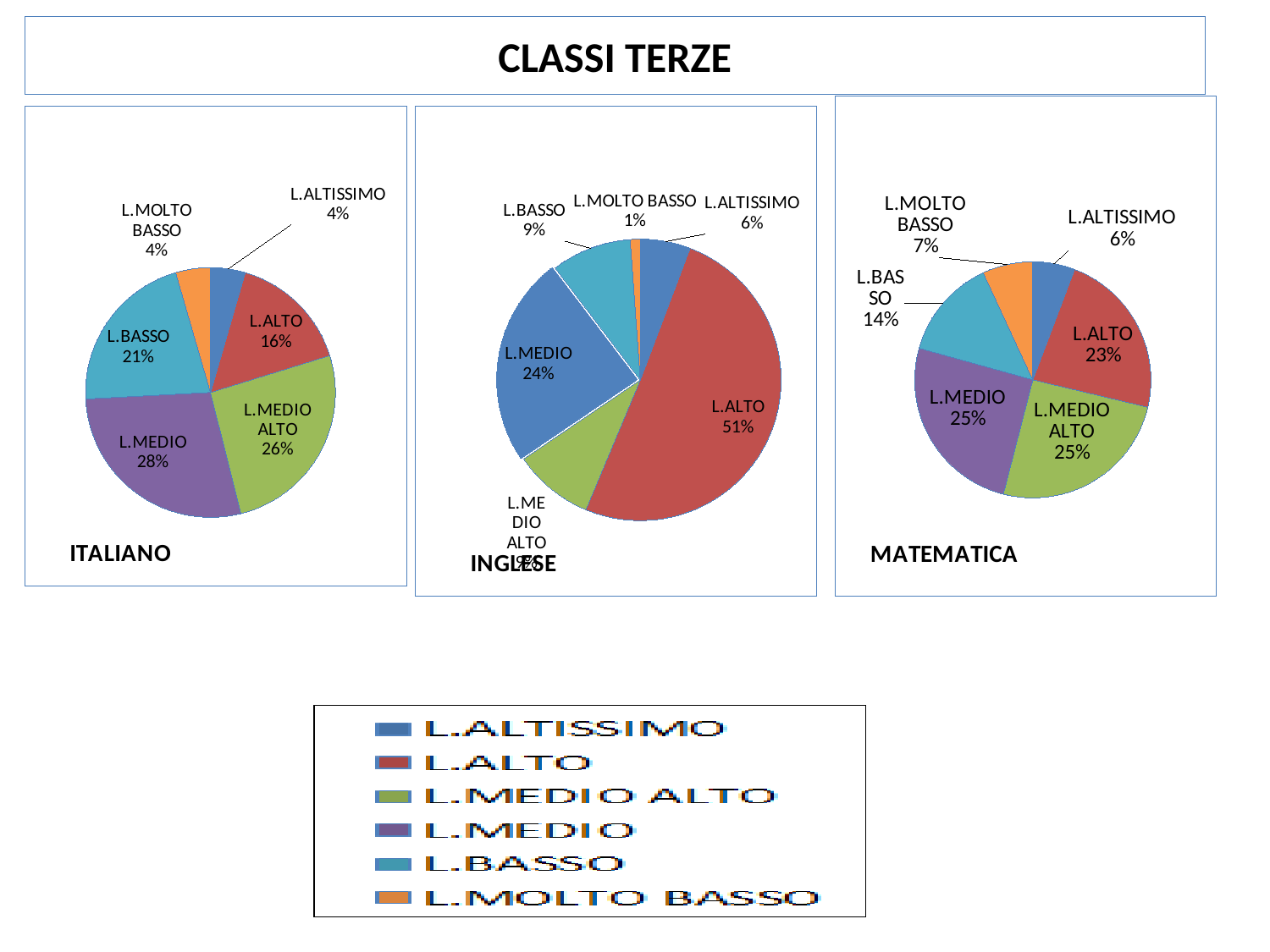
In the MATEMATICA pie chart, what percentage is L.MOLTO BASSO? 7% What is the title of the slide? CLASSI TERZE In the INGLESE pie chart, which level has the largest share? L.ALTO What kind of chart is used for ITALIANO, INGLESE and MATEMATICA? Pie chart In the ITALIANO pie chart, which level has the largest share? L.MEDIO How many entries does the legend list? 6 In the ITALIANO pie chart, what is the difference between L.MEDIO ALTO and L.ALTO? 10% In the INGLESE pie chart, what percentage is L.ALTO? 51% In the INGLESE pie chart, which level has the smallest share? L.MOLTO BASSO In the ITALIANO pie chart, what percentage is L.MEDIO? 28% In the MATEMATICA pie chart, which is larger, L.ALTO or L.BASSO? L.ALTO In the MATEMATICA pie chart, what percentage is L.BASSO? 14%